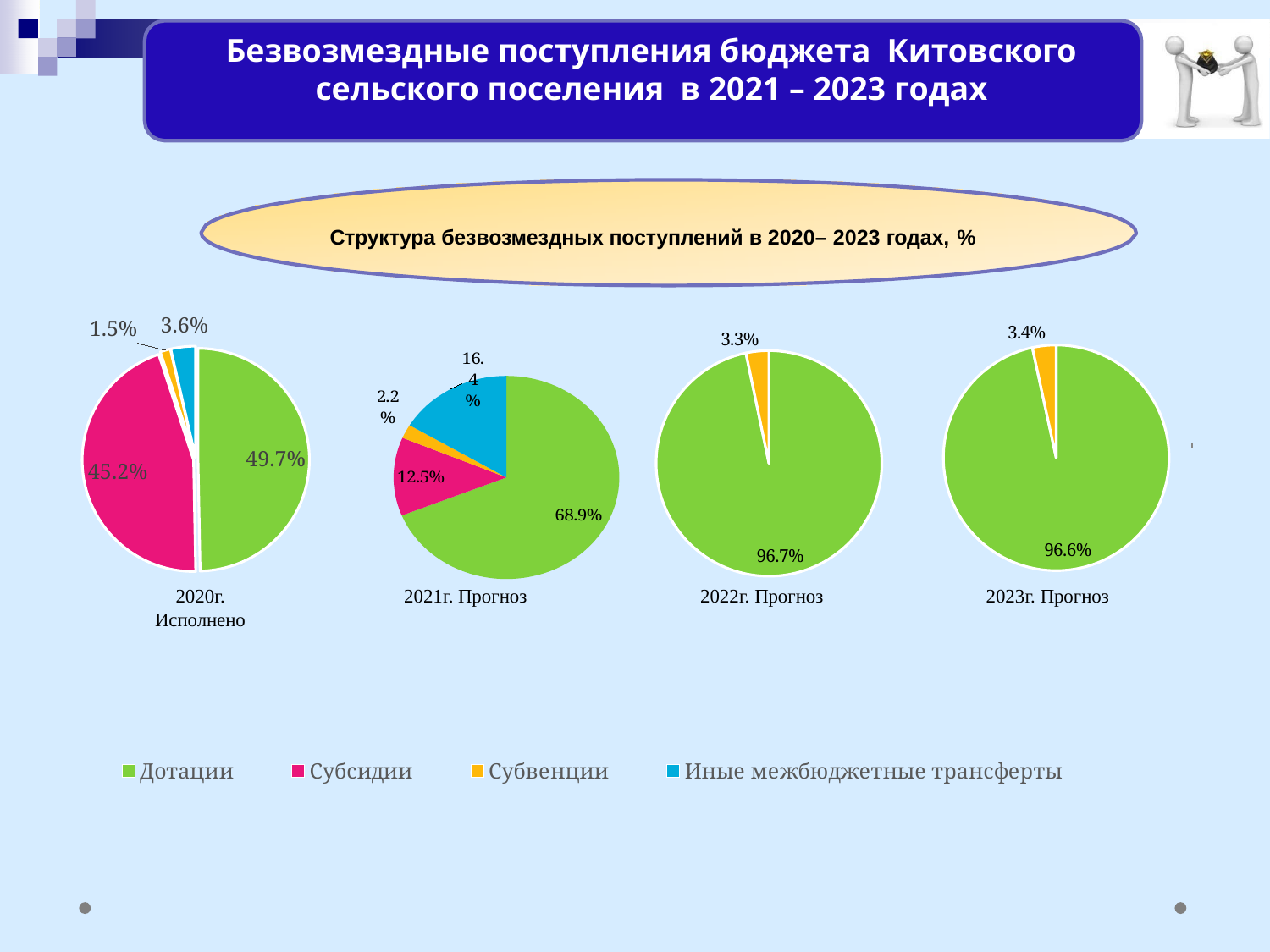
In the 2020г. Исполнено pie chart, which category has the smallest slice? Субвенции In the 2021г. Прогноз pie chart, what is the share for Дотации? 68.9% In the 2020г. Исполнено pie chart, what is the share for Субсидии? 45.2% In the 2021г. Прогноз pie chart, which is larger: the Субсидии slice or the Субвенции slice? Субсидии In the 2021г. Прогноз pie chart, which category has the largest slice? Дотации In the 2021г. Прогноз pie chart, what is the share for Субсидии? 12.5% In the 2023г. Прогноз pie chart, what is the share for Дотации? 96.6% In the 2022г. Прогноз pie chart, what is the share for Субвенции? 3.3% What kind of charts are shown on the slide? Pie charts In the 2020г. Исполнено pie chart, what is the difference between the Дотации share and the Субсидии share? 4.5% How many series does the legend list? 4 In the 2020г. Исполнено pie chart, what is the share for Дотации? 49.7%